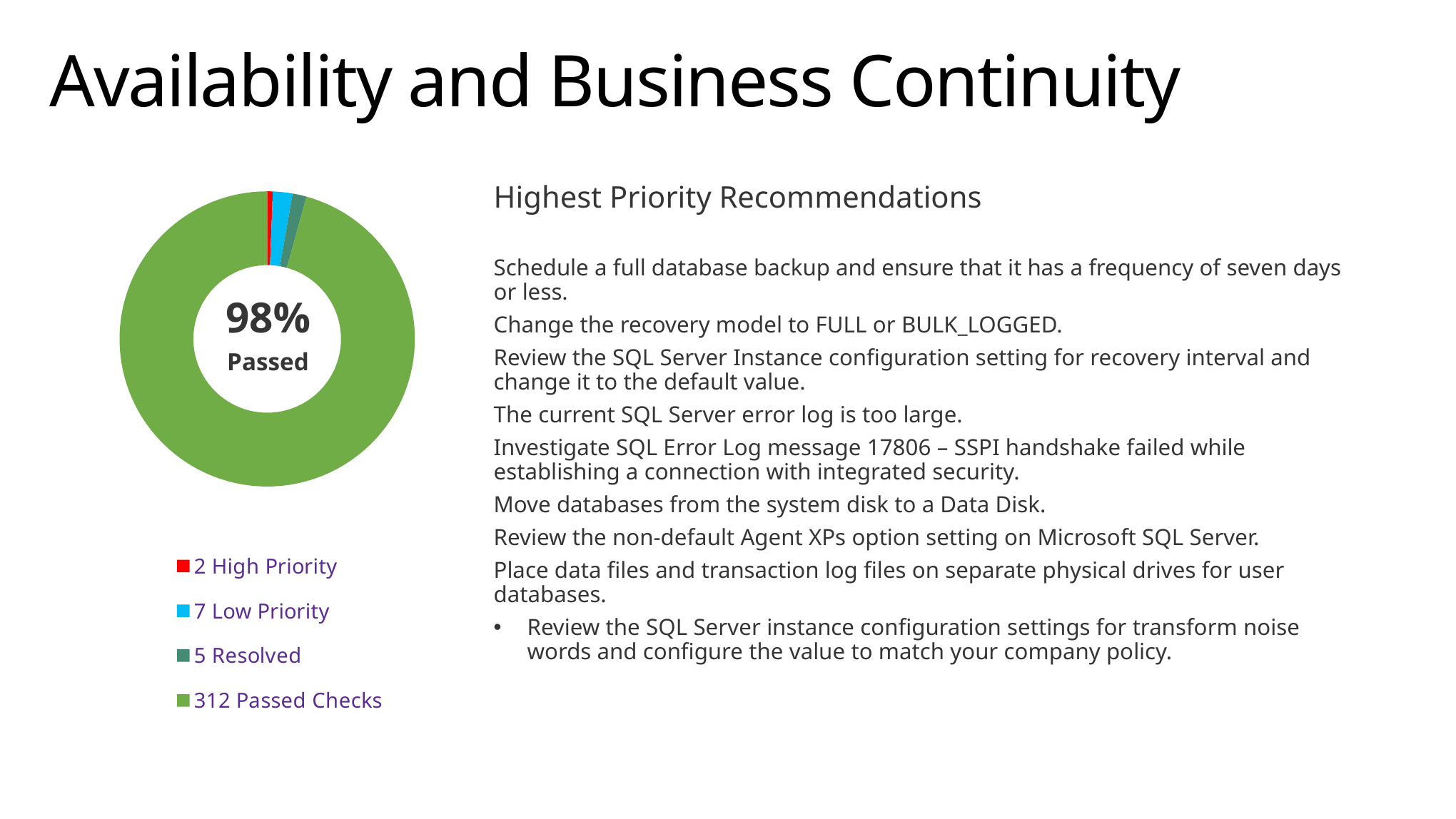
How many Resolved items does the legend show? 5 Which category has the largest slice of the donut chart? Passed Checks What colour represents Passed Checks in the donut chart? Green Which category has the smallest slice of the donut chart? High Priority How many Passed Checks does the legend show? 312 What percentage is shown in the centre of the donut chart? 98% How many High Priority items does the legend show? 2 What kind of chart is shown on the slide? Pie chart (donut) Which is larger, the number of Low Priority items or the number of Resolved items? Low Priority How many categories does the chart legend list? 4 What is the difference between the number of Low Priority items and the number of High Priority items? 5 How many Low Priority items does the legend show? 7